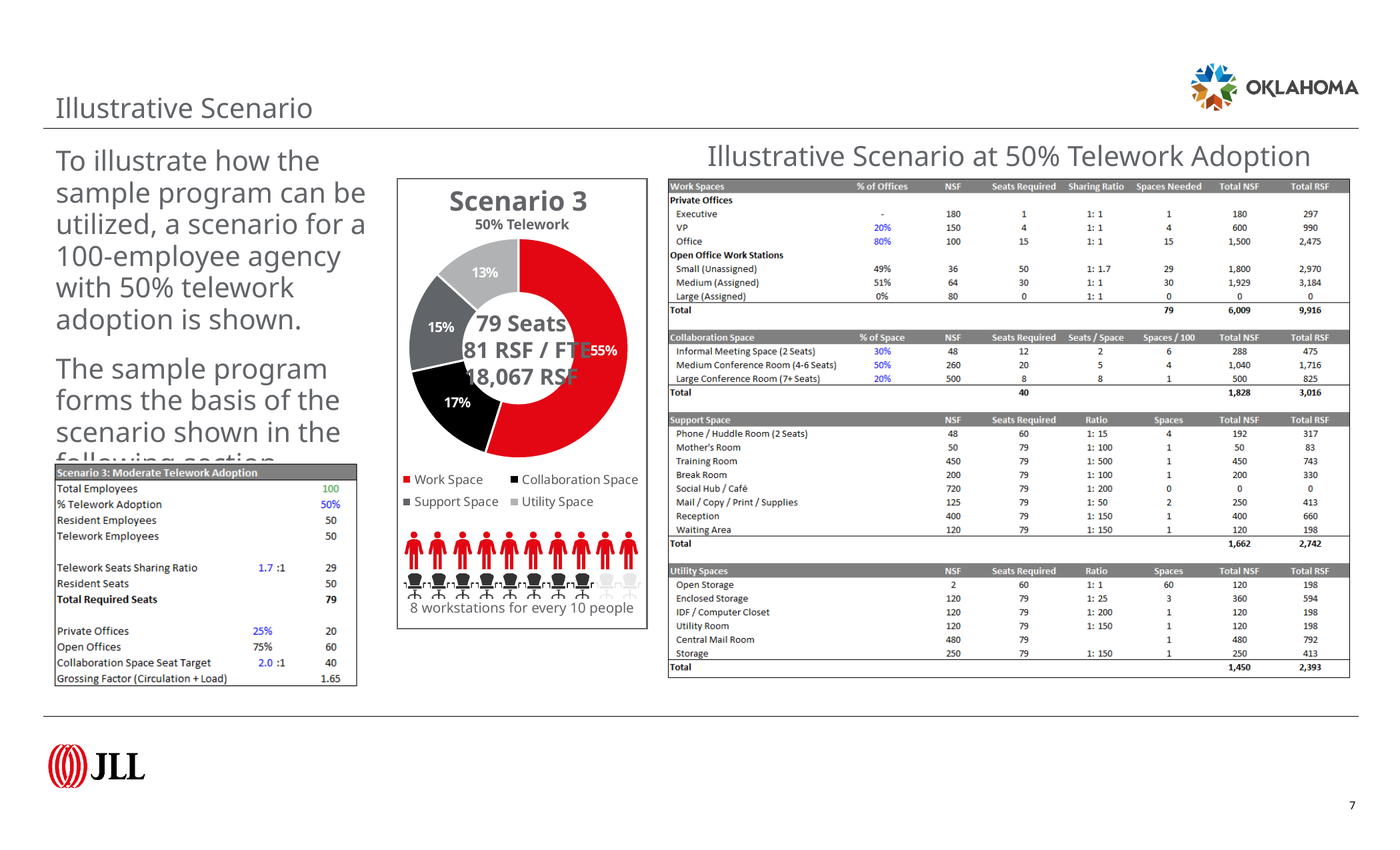
How many categories does the legend of the Scenario 3 chart list? 4 What telework percentage is shown in the subtitle of the Scenario 3 chart? 50% Telework Which category has the smallest slice in the Scenario 3 chart? Utility Space In the Scenario 3 chart, which is larger: Support Space or Utility Space? Support Space In the Scenario 3 chart, what share of space is Support Space? 15% In the Scenario 3 chart, what share of space is Work Space? 55% Which category has the largest slice in the Scenario 3 chart? Work Space What kind of chart is shown under the title "Scenario 3"? Donut (pie) chart What number of seats is printed in the center of the Scenario 3 chart? 79 Seats In the Scenario 3 chart, what is the difference in percentage points between Work Space and Collaboration Space? 38 percentage points In the Scenario 3 chart, what share of space is Utility Space? 13% In the Scenario 3 chart, what share of space is Collaboration Space? 17%